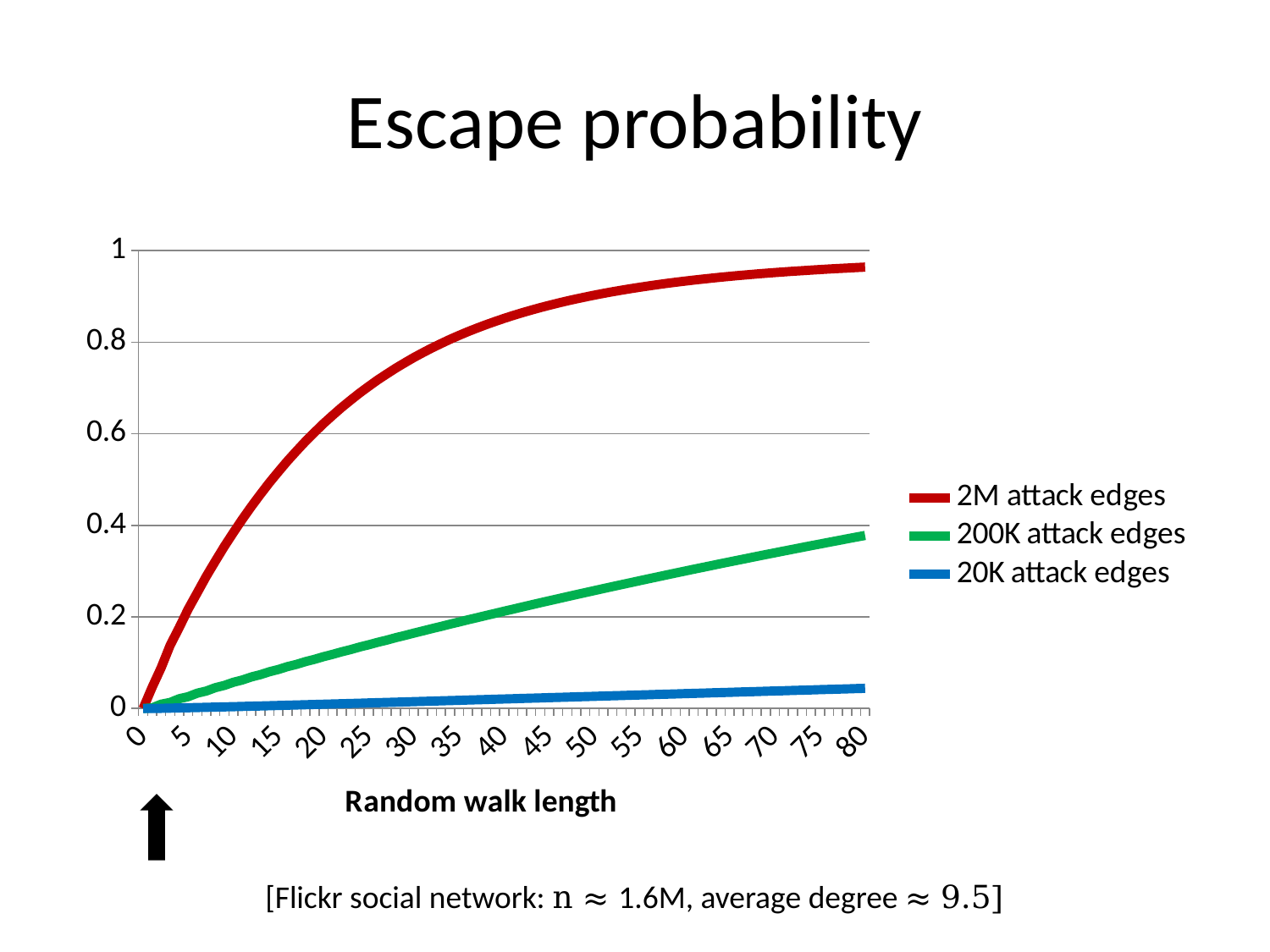
At a random walk length of 40, which is larger: the value for 2M attack edges or the value for 200K attack edges? 2M attack edges How many series does the legend list? 3 Does the escape probability for 200K attack edges rise or fall as the random walk length increases? rise What is the label of the x axis? Random walk length Is the value for 2M attack edges at a random walk length of 80 greater or less than 0.8? greater Is the value for 200K attack edges at a random walk length of 60 greater or less than 0.2? greater Is the value for 2M attack edges at a random walk length of 20 greater or less than 0.4? greater Which series has the lowest escape probability at a random walk length of 80? 20K attack edges What kind of chart is shown on the slide? line chart Which series has the highest escape probability at a random walk length of 80? 2M attack edges What is the title of the chart? Escape probability